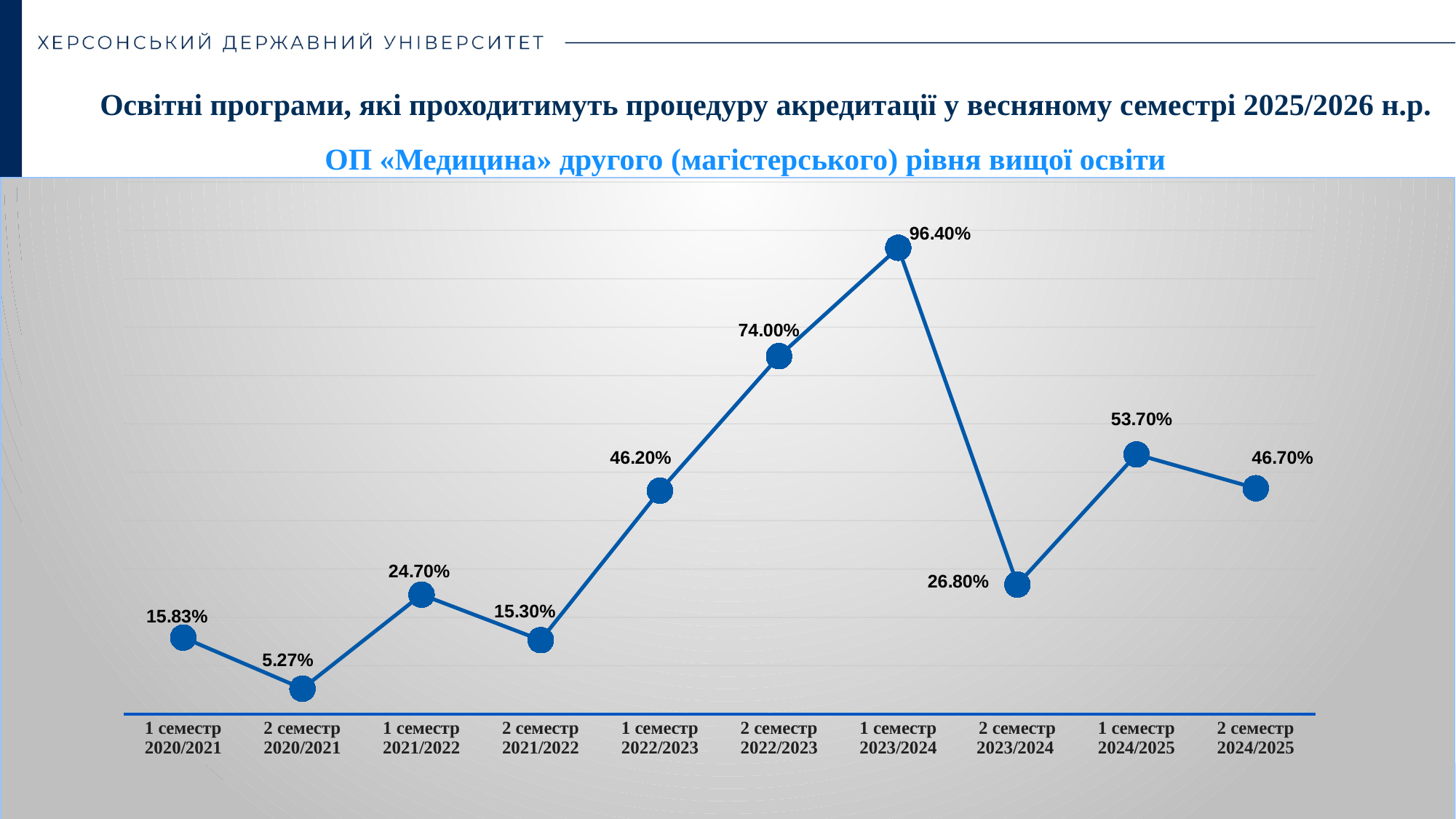
Which is larger: the value for 1 семестр 2024/2025 or the value for 1 семестр 2022/2023? 1 семестр 2024/2025 What is the difference between the values for 1 семестр 2021/2022 and 2 семестр 2021/2022? 9.40% What type of chart is shown on the slide? line chart Does the value rise or fall from 2 семестр 2021/2022 to 1 семестр 2023/2024? rise Which semester has the lowest value? 2 семестр 2020/2021 What is the difference between the values for 1 семестр 2023/2024 and 2 семестр 2023/2024? 69.60% What is the value for 2 семестр 2024/2025? 46.70% What is the value for 1 семестр 2020/2021? 15.83% What is the value for 2 семестр 2022/2023? 74.00% How many data points are plotted on the chart? 10 Which semester has the highest value? 1 семестр 2023/2024 What is the subtitle of the chart shown in blue above it? ОП «Медицина» другого (магістерського) рівня вищої освіти